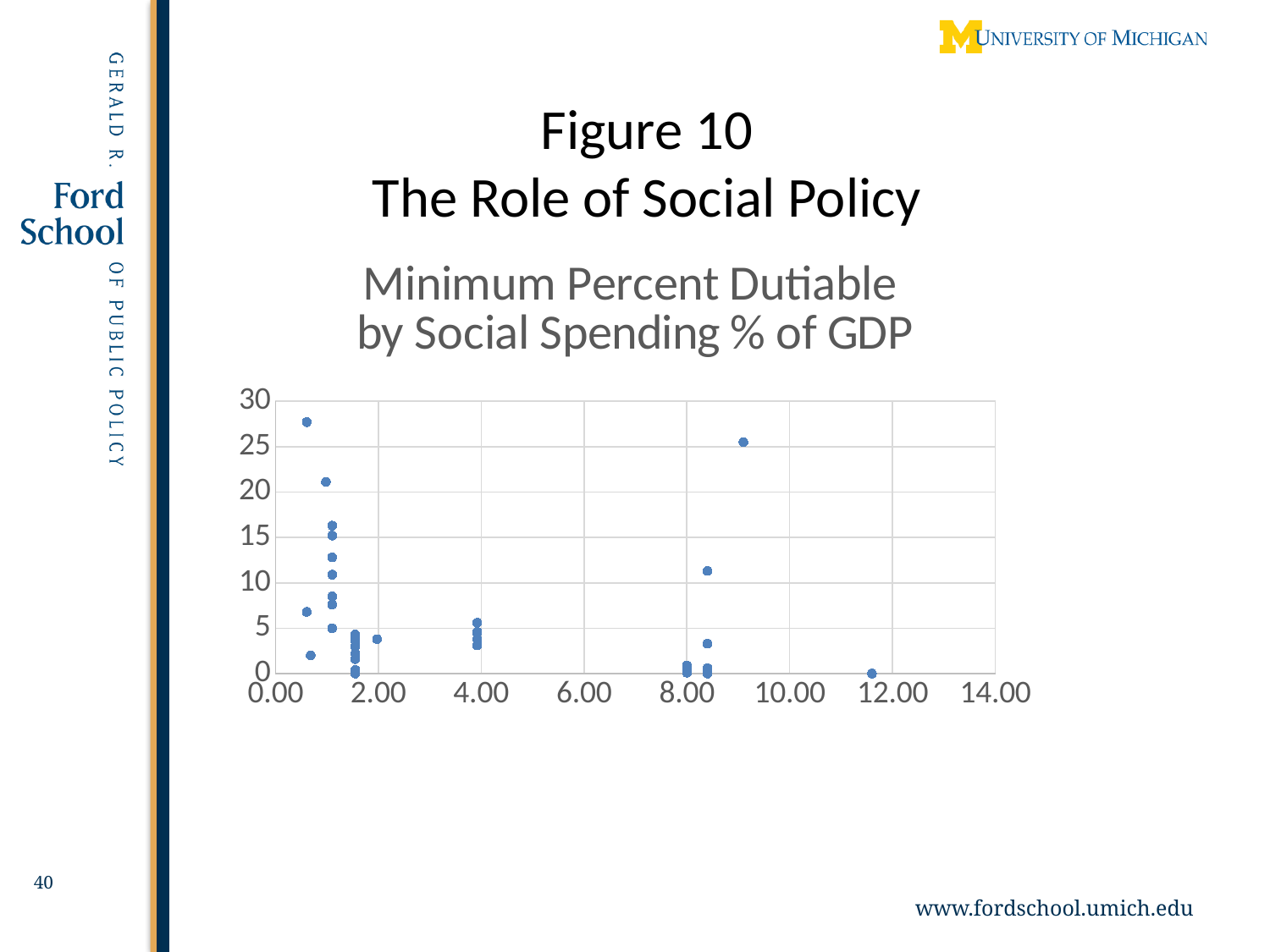
What is the title of the chart? Minimum Percent Dutiable by Social Spending % of GDP Is the highest point near 8.40 on the x axis greater or less than 10 on the y axis? greater What kind of chart is shown on the slide? scatter chart Are the points near 4.00 on the x axis greater or less than 10 on the y axis? less Is the point near 2.00 on the x axis greater or less than 5 on the y axis? less Which has the higher y value: the highest point near 0.60 on the x axis or the point near 9.00 on the x axis? the point near 0.60 What is the highest value labelled on the y axis of the chart? 30 Which has the higher y value: the point near 9.00 on the x axis or the highest point near 8.40 on the x axis? the point near 9.00